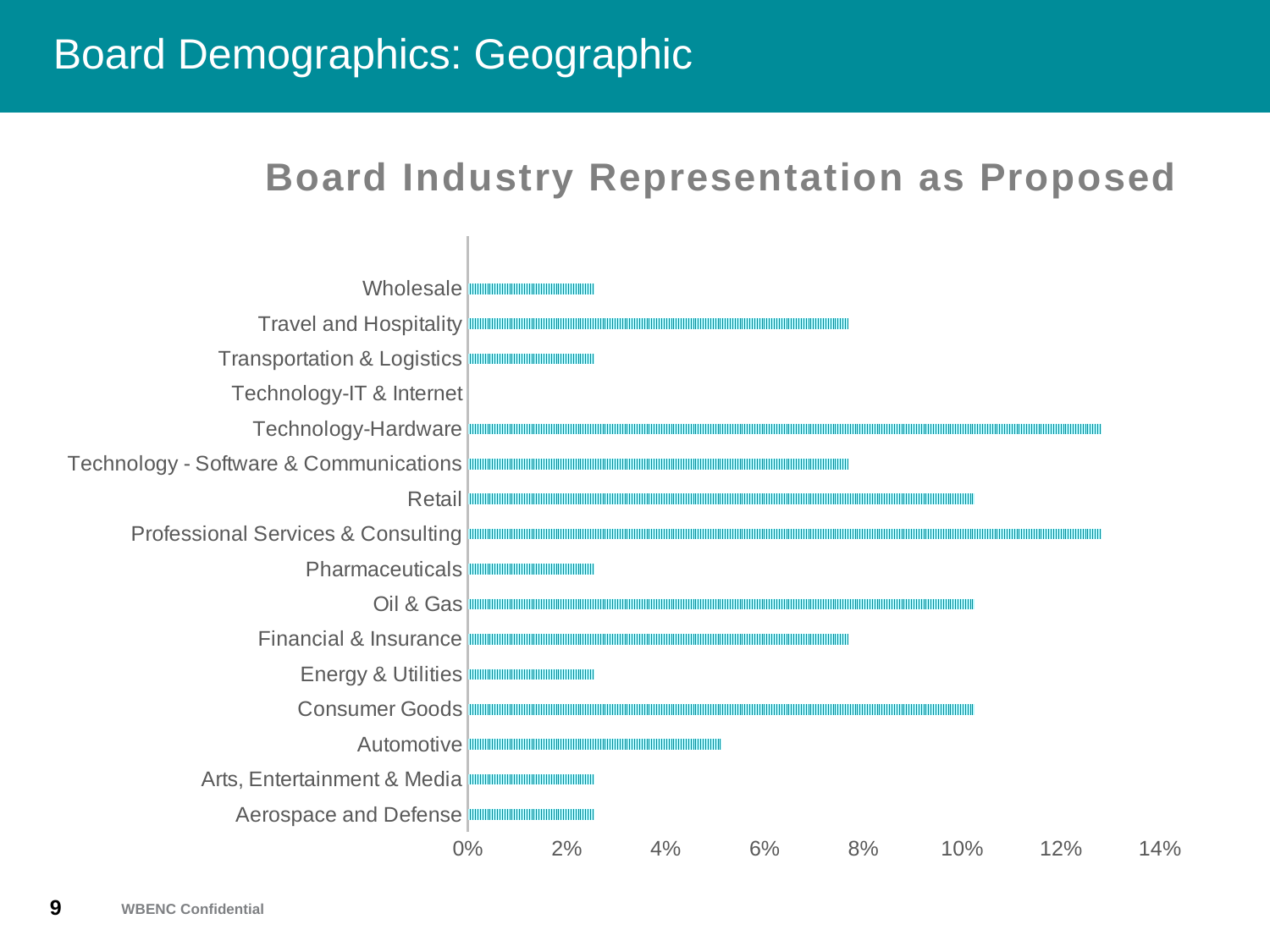
Which is larger, the value for Pharmaceuticals or the value for Financial & Insurance? Financial & Insurance Is the value for Technology-Hardware greater or less than 12%? greater Is the value for Automotive greater or less than 6%? less How many industry categories are plotted on the chart? 16 What is the highest value shown on the horizontal axis? 14% Which is larger, the value for Retail or the value for Automotive? Retail What is the title of the chart? Board Industry Representation as Proposed Which industry has the lowest representation on the chart? Technology-IT & Internet Is the value for Wholesale greater or less than 4%? less What kind of chart is shown on the slide? Bar chart